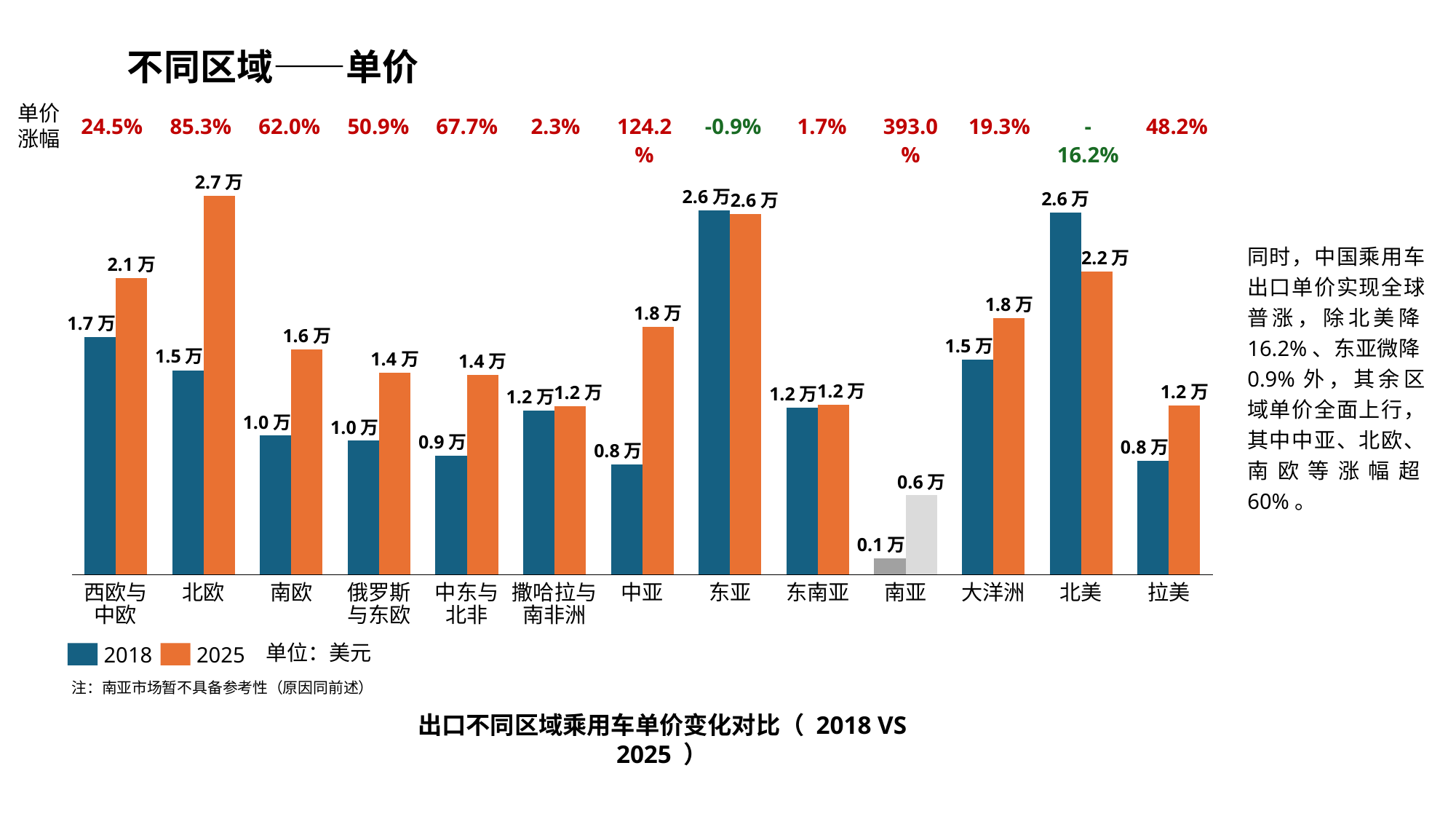
For 北美, which is larger: the 2018 unit price or the 2025 unit price? 2018 What is the unit price growth rate (单价涨幅) shown for 南亚? 393.0% How many regions are shown on the x axis? 13 Which region has the highest 2025 unit price? 北欧 What is the 2025 unit price for 北欧? 2.7万 What is the 2025 unit price for 中亚? 1.8万 What kind of chart is shown on the slide? Bar chart Which region has the lowest 2018 unit price? 南亚 How many series does the legend list? 2 What is the difference between the 2025 and 2018 unit prices for 北欧? 1.2万 What is the 2018 unit price for 西欧与中欧? 1.7万 What unit is stated for the values in the chart? 美元